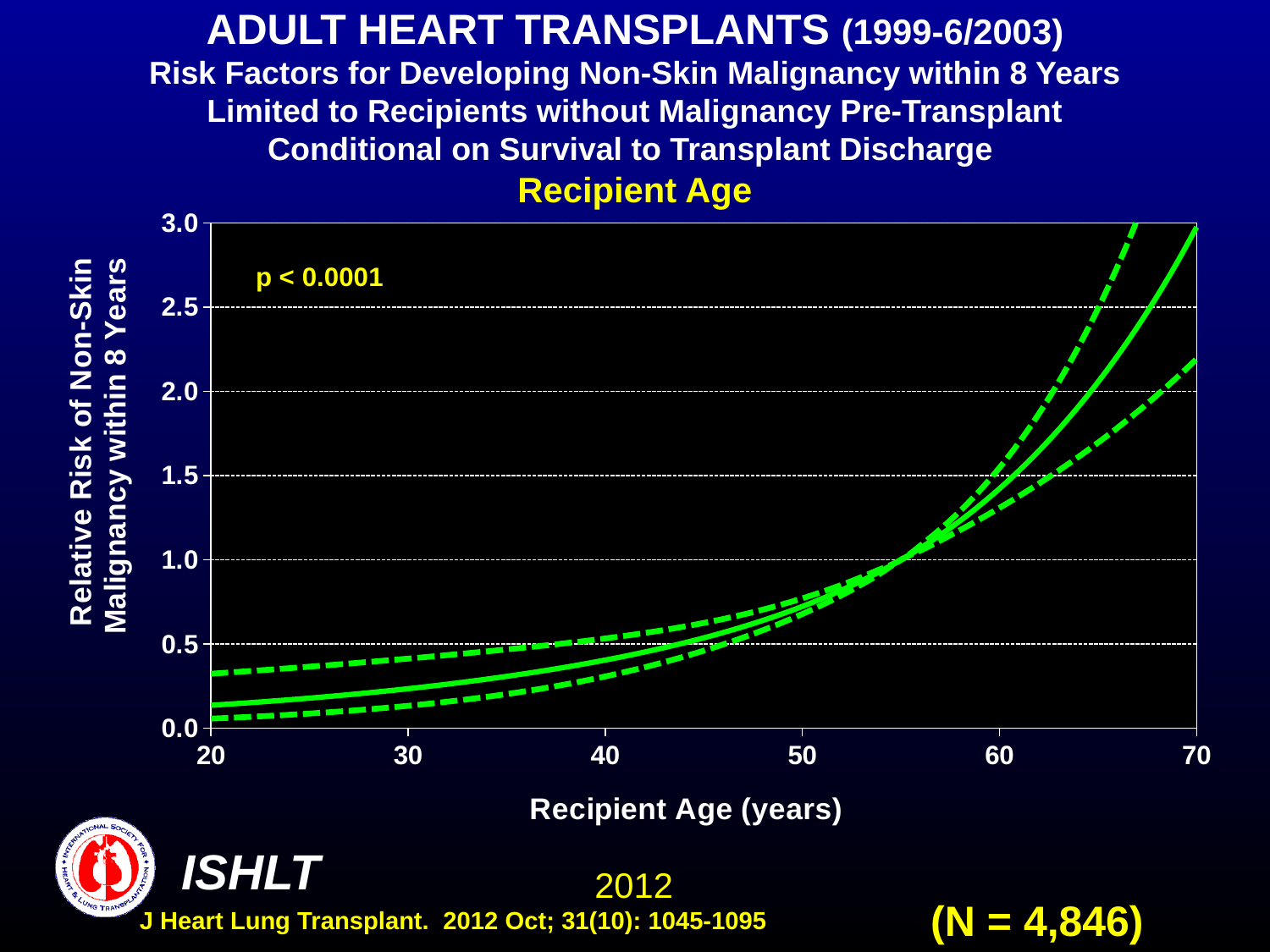
What p-value is printed on the chart? p < 0.0001 Does the relative risk of non-skin malignancy rise or fall as recipient age increases from 20 to 70 years? rise Is the relative risk on the solid line at recipient age 70 greater or less than 2.5? greater Is the relative risk on the solid line at recipient age 40 greater or less than 0.5? less Is the relative risk on the solid line at recipient age 20 greater or less than 0.5? less How many tick labels are shown on the Recipient Age (years) axis? 6 What sample size (N) is shown on the slide? N = 4,846 On the solid line, is the relative risk larger at recipient age 60 or at recipient age 40? 60 What kind of chart is shown on the slide? line chart How many lines (solid and dashed) are plotted on the chart? 3